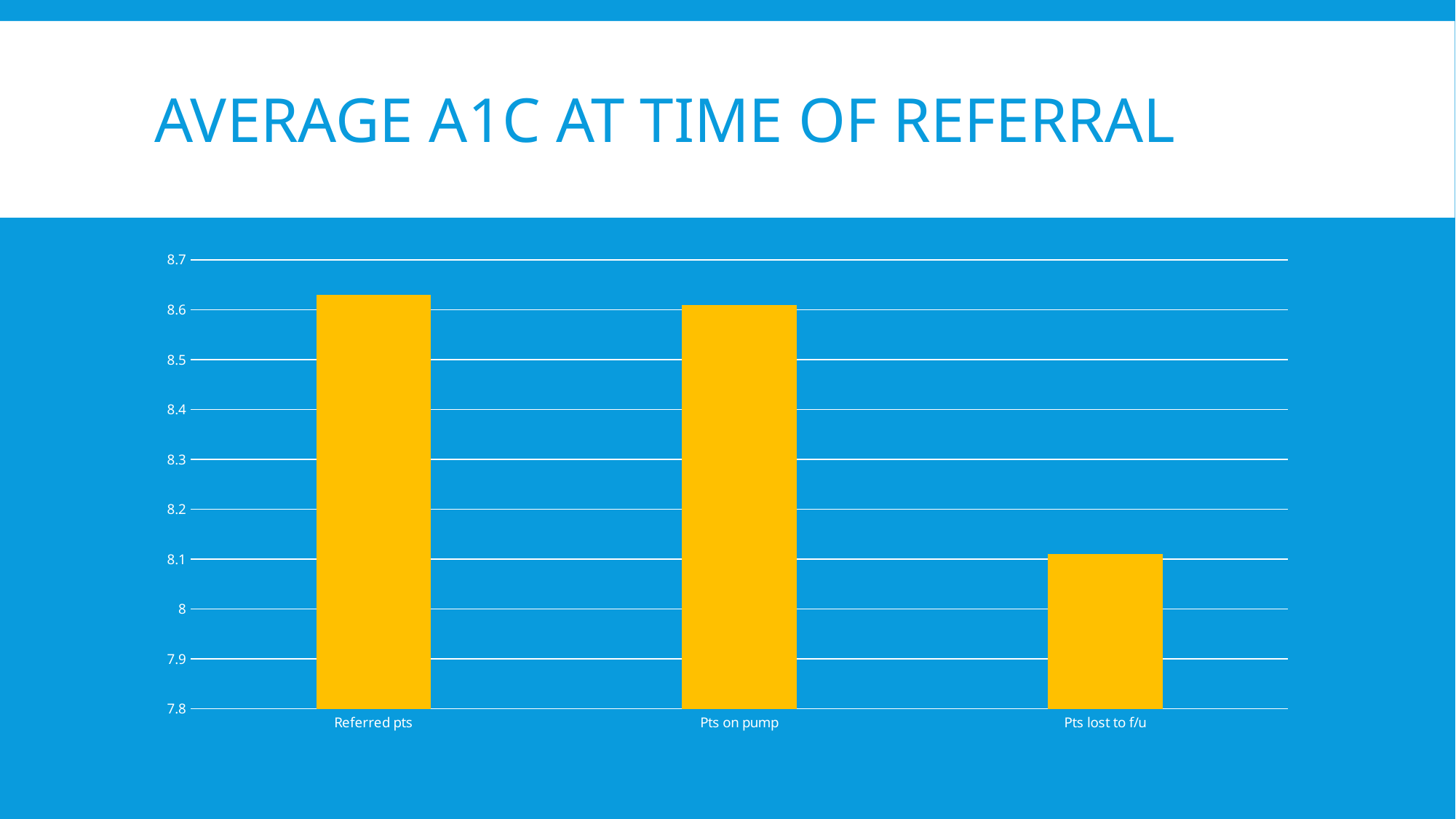
Which is larger, the value for Pts on pump or the value for Pts lost to f/u? Pts on pump What is the lowest value shown on the y axis of the chart? 7.8 Is the value for Pts lost to f/u greater or less than 8.3? less Is the value for Pts on pump greater or less than 8.5? greater Do the values rise or fall moving from left to right along the x axis? fall What is the title of the slide containing the chart? AVERAGE A1C AT TIME OF REFERRAL Is the value for Pts lost to f/u greater or less than 8? greater What kind of chart is shown on the slide? bar chart Which category has the lowest average A1C at time of referral? Pts lost to f/u How many categories are shown on the x axis of the chart? 3 Which is larger, the value for Referred pts or the value for Pts lost to f/u? Referred pts